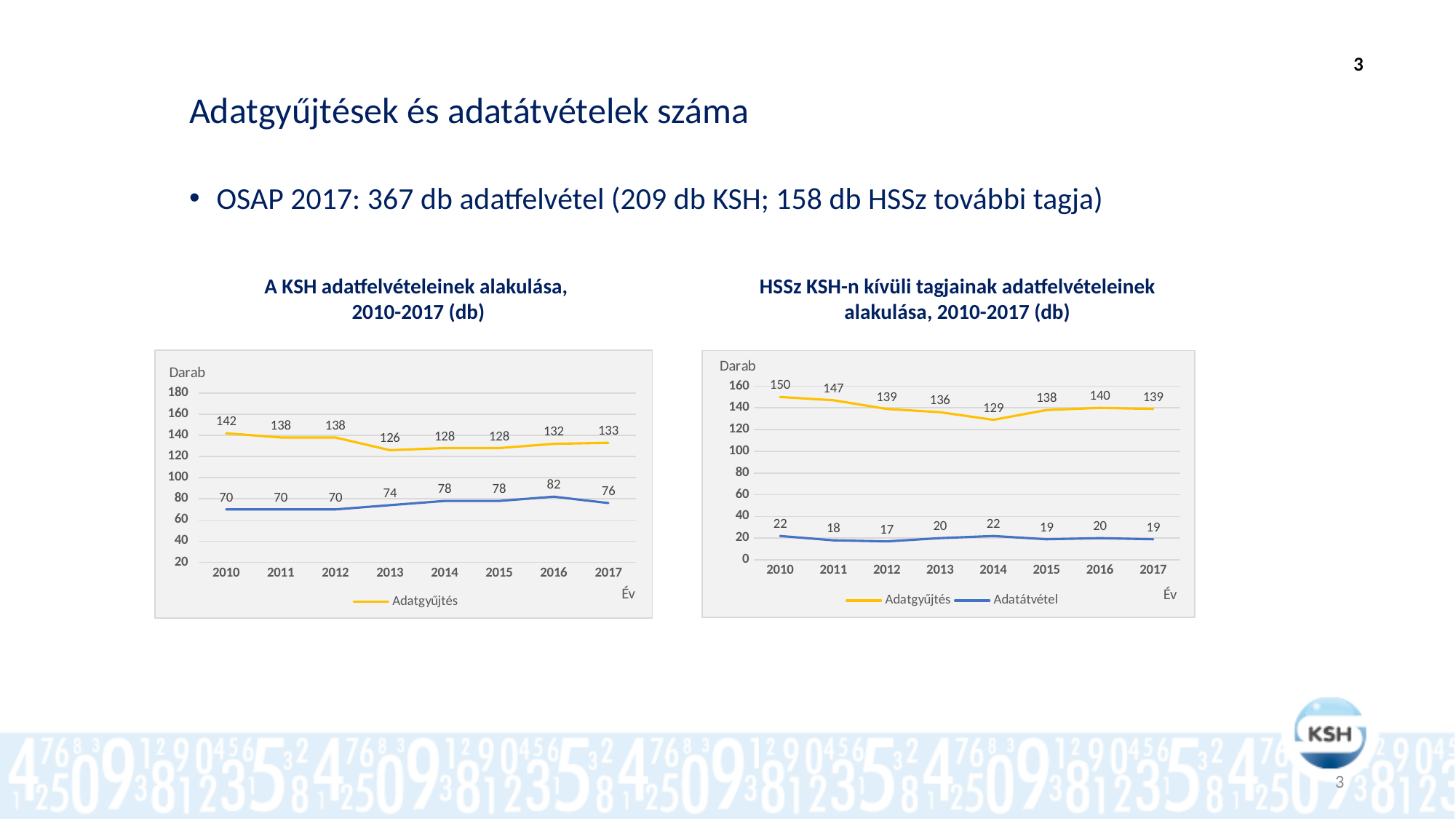
How many years are plotted on the x axis of the right chart (HSSz KSH-n kívüli tagjainak adatfelvételeinek alakulása)? 8 In the left chart (A KSH adatfelvételeinek alakulása), what is the difference between the Adatgyűjtés values for 2010 and 2017? 9 In the right chart (HSSz KSH-n kívüli tagjainak adatfelvételeinek alakulása), in which year is the Adatgyűjtés value highest? 2010 In the right chart (HSSz KSH-n kívüli tagjainak adatfelvételeinek alakulása), what is the Adatátvétel value for 2012? 17 In the right chart (HSSz KSH-n kívüli tagjainak adatfelvételeinek alakulása), what is the Adatgyűjtés value for 2014? 129 In the left chart (A KSH adatfelvételeinek alakulása), how many series does the legend list? 1 In the left chart (A KSH adatfelvételeinek alakulása), what is the value of the blue line for 2016? 82 In the right chart (HSSz KSH-n kívüli tagjainak adatfelvételeinek alakulása), how many series does the legend list? 2 In the left chart (A KSH adatfelvételeinek alakulása), what is the Adatgyűjtés value for 2010? 142 In the right chart (HSSz KSH-n kívüli tagjainak adatfelvételeinek alakulása), which is larger: the Adatgyűjtés value for 2011 or for 2015? 2011 In the left chart (A KSH adatfelvételeinek alakulása), in which year is the Adatgyűjtés value lowest? 2013 What kind of chart is the left chart (A KSH adatfelvételeinek alakulása)? Line chart